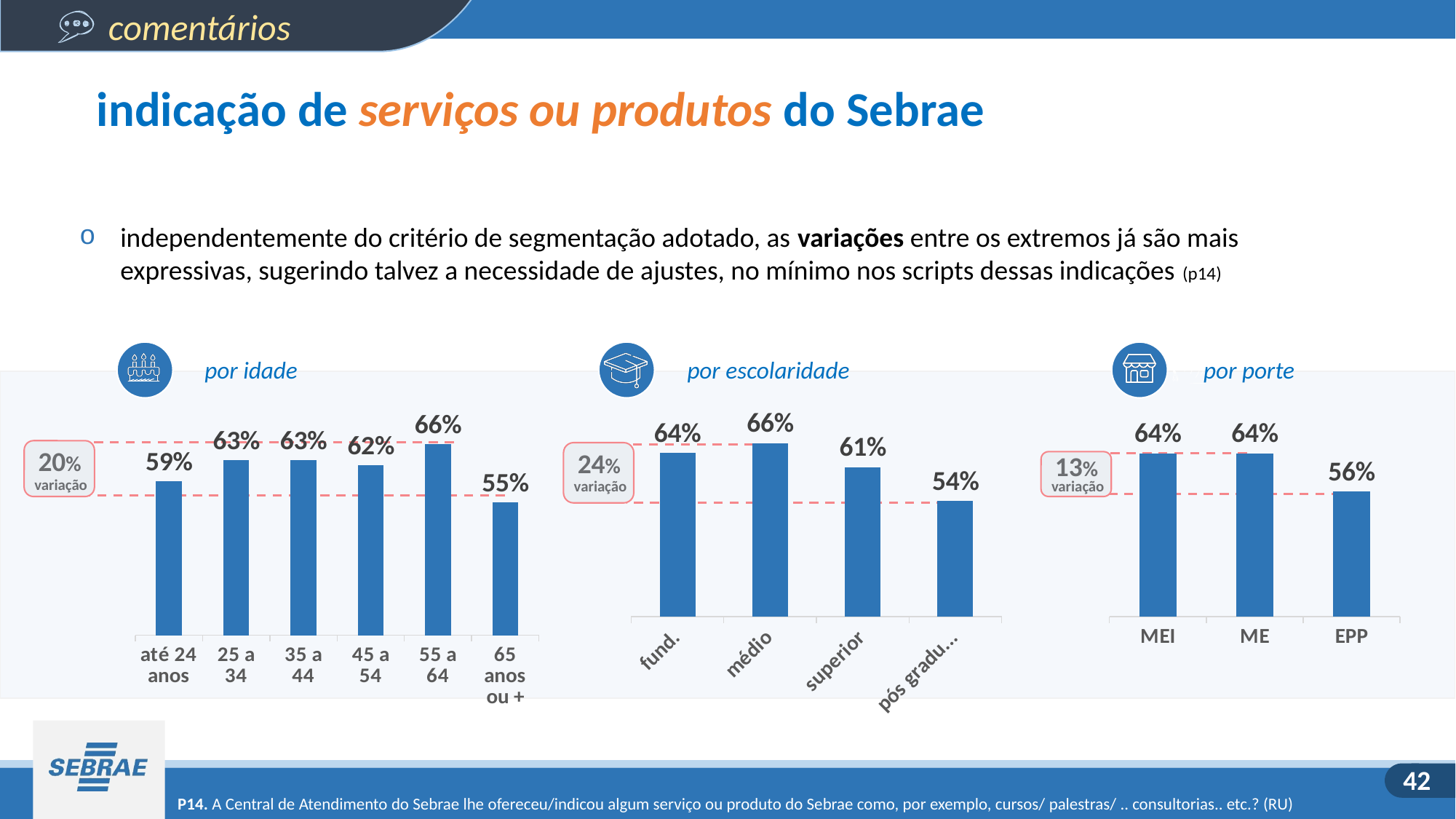
In the 'por porte' chart, which is larger, the value for 'ME' or the value for 'EPP'? ME In the 'por porte' chart, what is the value for 'EPP'? 56% In the 'por escolaridade' chart, what is the value for 'médio'? 66% What kind of chart is the 'por porte' chart? bar chart In the 'por escolaridade' chart, which category has the highest value? médio In the 'por idade' chart, what is the difference between the values for '55 a 64' and '65 anos ou +'? 11% In the 'por escolaridade' chart, do the values rise or fall from 'médio' to 'pós gradu...'? fall In the 'por idade' chart, what is the value for '55 a 64'? 66% In the 'por escolaridade' chart, what is the difference between the values for 'fund.' and 'superior'? 3% In the 'por idade' chart, which age group has the lowest value? 65 anos ou + In the 'por idade' chart, how many age categories are shown? 6 In the 'por idade' chart, what is the value for 'até 24 anos'? 59%